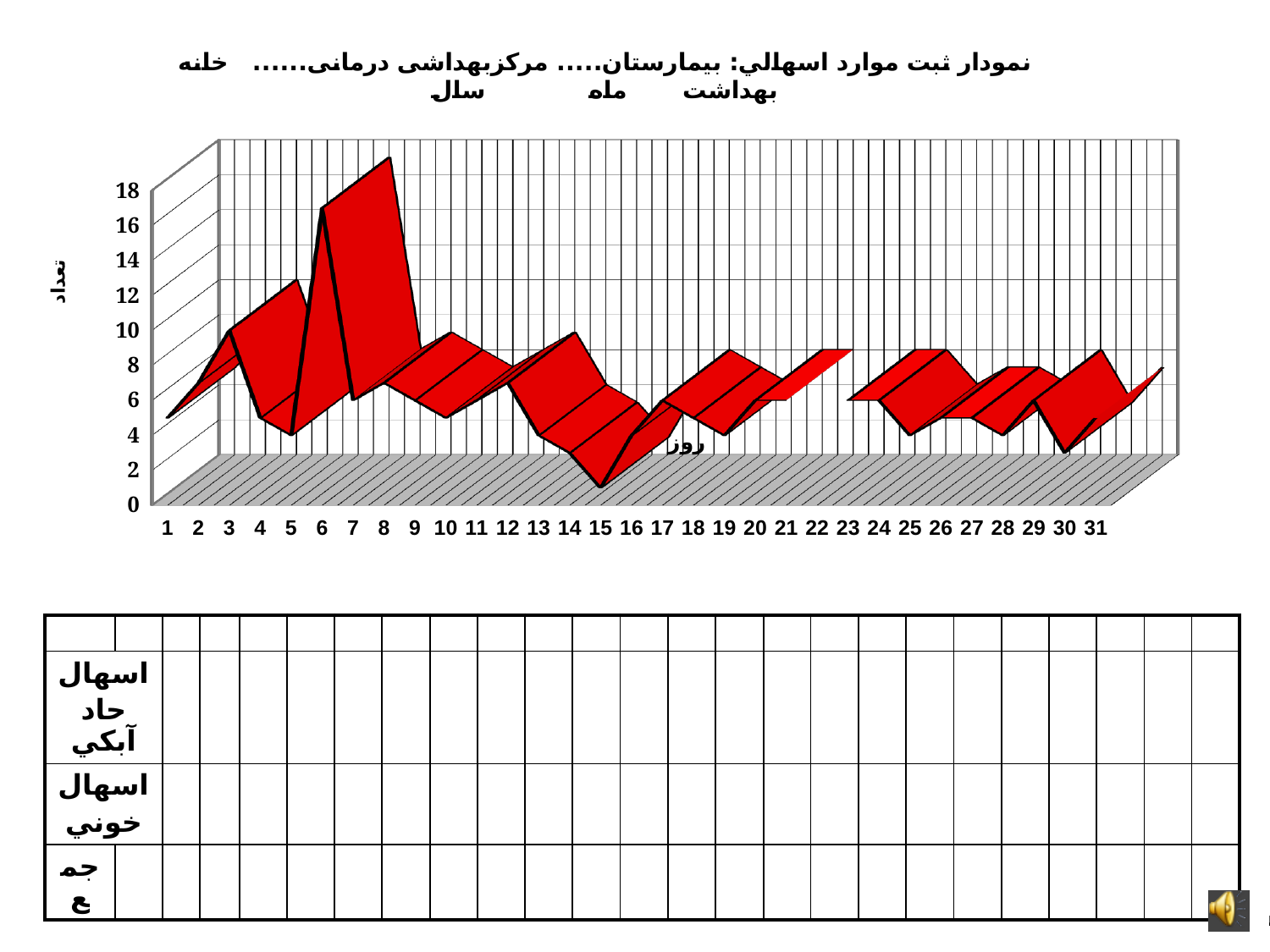
Which day has the larger value, day 8 or day 15? day 8 What is the title of the vertical axis? تعداد On which day does the chart reach its highest value? 6 Which day has the larger value, day 5 or day 6? day 6 What kind of chart is shown on the slide? line chart Is the value for day 15 greater or less than 4? less What is the highest tick value shown on the vertical axis? 18 On which day does the chart reach its lowest value? 15 Is the value for day 6 greater or less than 10? greater How many days are plotted along the x axis of the chart? 31 Is the value for day 8 greater or less than 14? less